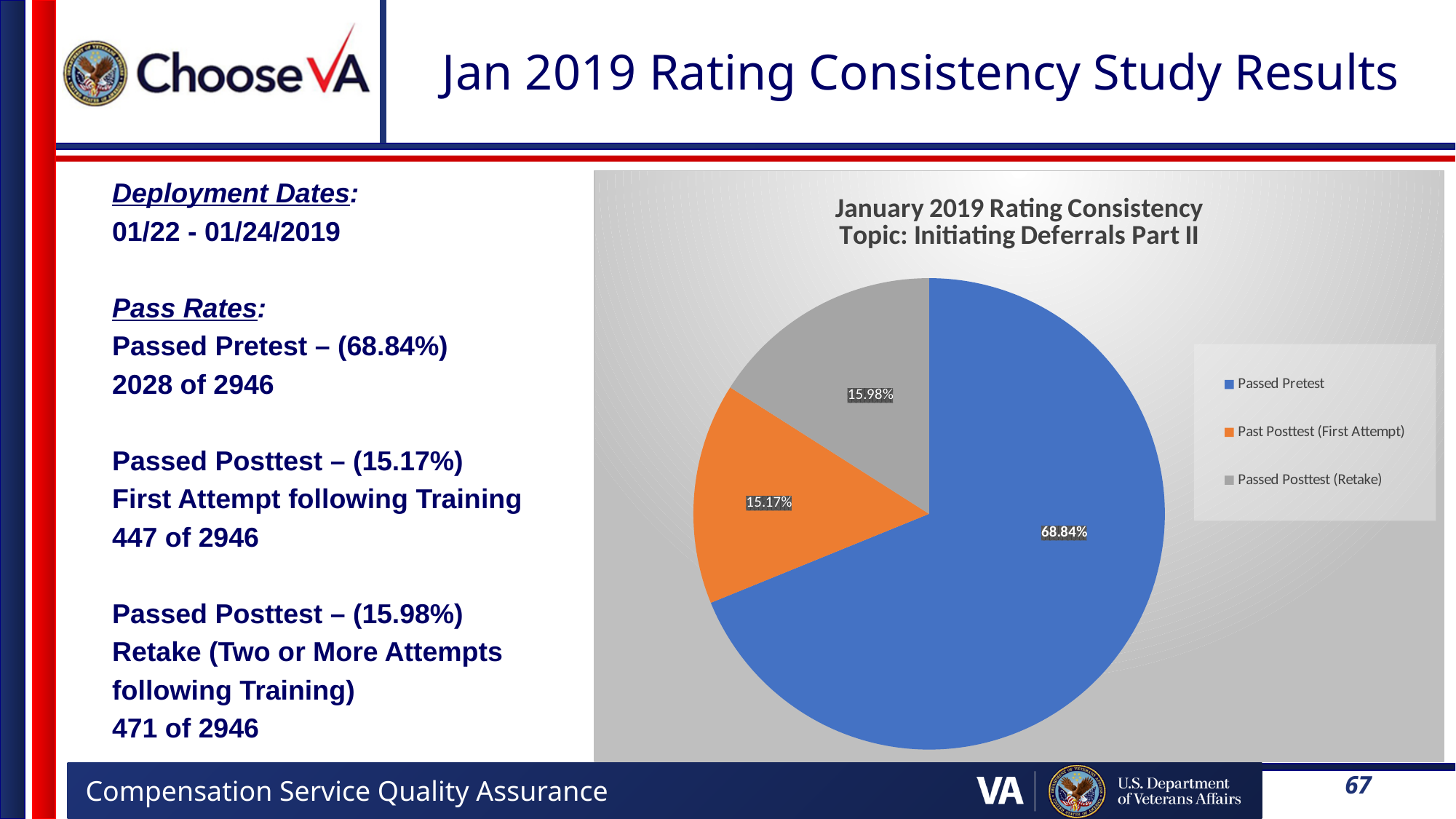
What is the difference between the Passed Pretest share and the Passed Posttest (Retake) share? 52.86% How many slices does the pie chart have? 3 Which is larger: the Passed Pretest slice or the Past Posttest (First Attempt) slice? Passed Pretest What share of the pie does Passed Posttest (Retake) represent? 15.98% Which category has the largest slice of the pie? Passed Pretest What share of the pie does Past Posttest (First Attempt) represent? 15.17% What type of chart is shown on the slide? pie chart What is the title of the chart? January 2019 Rating Consistency Topic: Initiating Deferrals Part II What is the difference between the Passed Posttest (Retake) share and the Past Posttest (First Attempt) share? 0.81% Which category has the smallest slice of the pie? Past Posttest (First Attempt) What share of the pie does Passed Pretest represent? 68.84% How many entries does the chart legend list? 3